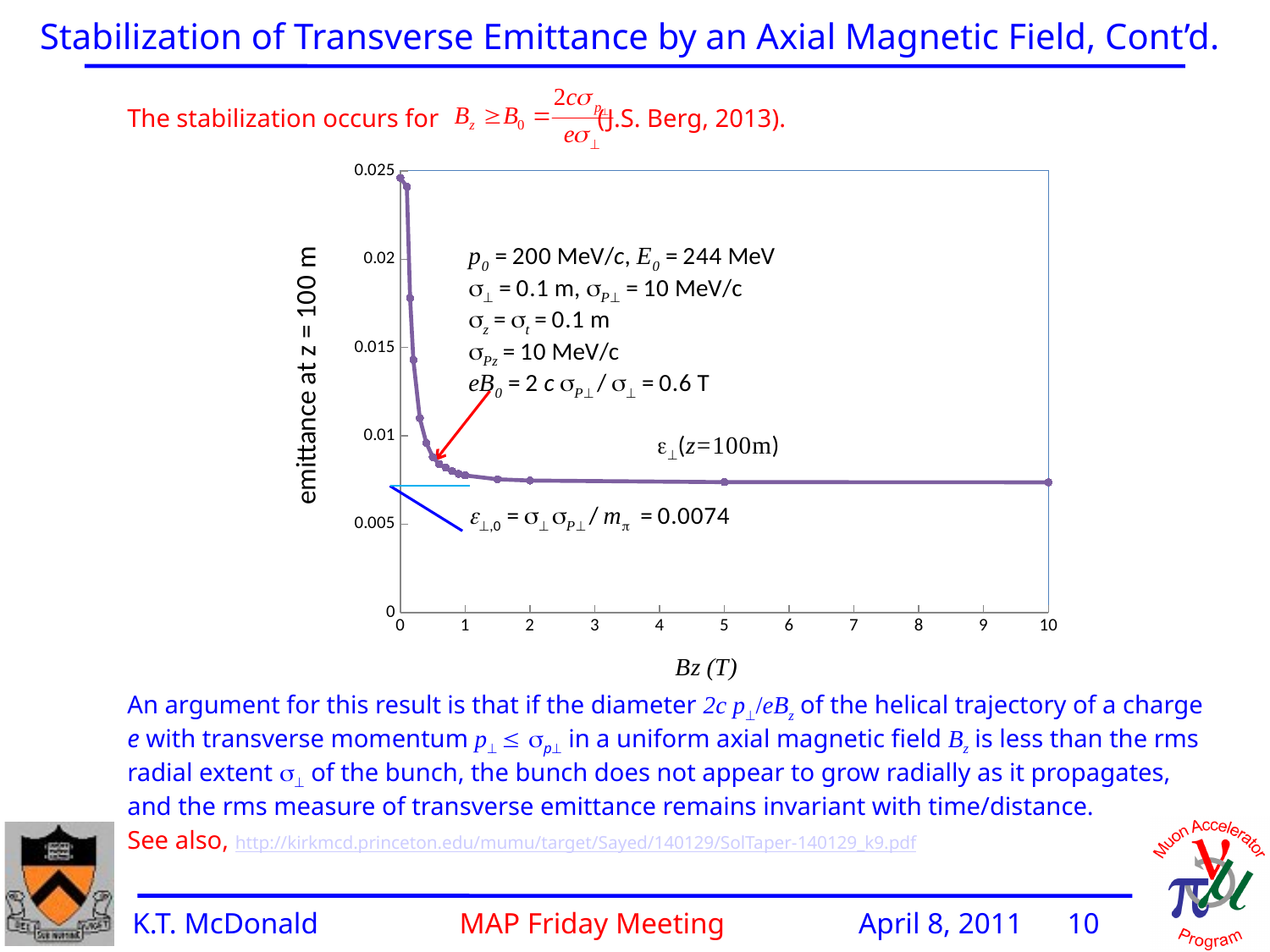
What kind of chart is shown on the slide? line chart What asymptotic value of the emittance ε⊥,0 is annotated on the chart? 0.0074 Is the emittance at Bz = 2 T greater or less than 0.015? less Which has the larger emittance, Bz = 0 or Bz = 10 T? Bz = 0 What is the label of the y axis of the chart? emittance at z = 100 m Is the emittance at Bz = 0 greater or less than 0.02? greater Is the emittance at Bz = 10 T greater or less than 0.01? less What is the label of the x axis of the chart? Bz (T) At which Bz value is the emittance highest? 0 What is the highest value shown on the y axis of the chart? 0.025 Does the emittance rise or fall as Bz increases along the x axis? fall